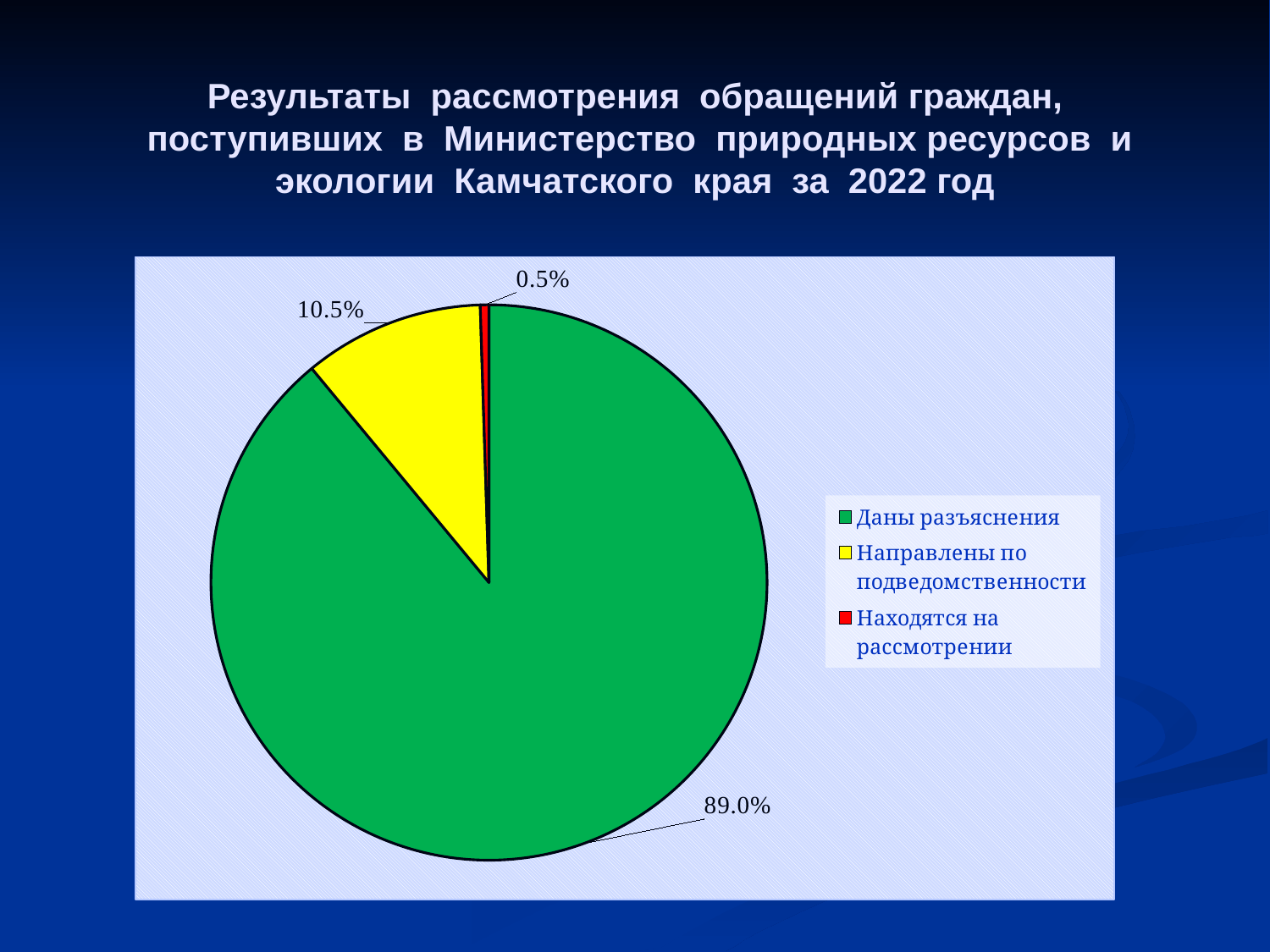
What colour is the slice for "Находятся на рассмотрении"? red What share of the pie is labelled "Даны разъяснения"? 89.0% Which category has the smallest slice of the pie? Находятся на рассмотрении What colour is the slice for "Направлены по подведомственности"? yellow Which category has the largest slice of the pie? Даны разъяснения What kind of chart is shown on the slide? pie chart Which is larger: the "Направлены по подведомственности" slice or the "Находятся на рассмотрении" slice? Направлены по подведомственности How many slices does the pie chart have? 3 What share of the pie is labelled "Направлены по подведомственности"? 10.5% What share of the pie is labelled "Находятся на рассмотрении"? 0.5% What is the difference in percentage points between the "Даны разъяснения" slice and the "Направлены по подведомственности" slice? 78.5 How many entries does the legend list? 3